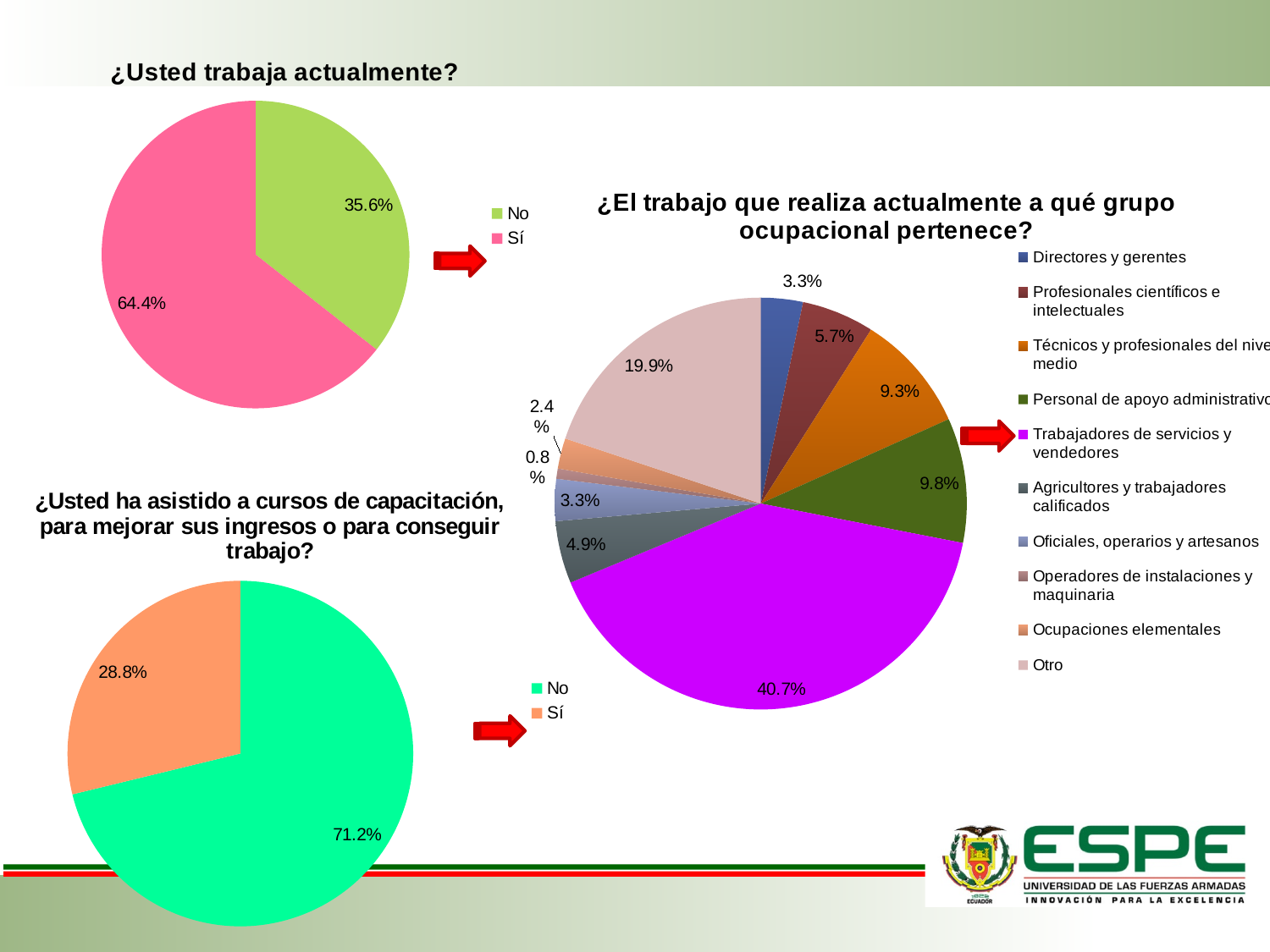
In the chart titled '¿El trabajo que realiza actualmente a qué grupo ocupacional pertenece?', how many occupational groups does the legend list? 10 In the chart titled '¿El trabajo que realiza actualmente a qué grupo ocupacional pertenece?', which group has the largest share? Trabajadores de servicios y vendedores In the chart titled '¿El trabajo que realiza actualmente a qué grupo ocupacional pertenece?', what is the difference between the shares for Trabajadores de servicios y vendedores and Otro? 20.8% In the chart titled '¿Usted trabaja actualmente?', what percentage answered Sí? 64.4% In the chart titled '¿Usted ha asistido a cursos de capacitación, para mejorar sus ingresos o para conseguir trabajo?', which answer has the larger share, Sí or No? No In the chart titled '¿Usted trabaja actualmente?', what percentage answered No? 35.6% In the chart titled '¿El trabajo que realiza actualmente a qué grupo ocupacional pertenece?', which group has the smallest share? Operadores de instalaciones y maquinaria What kind of chart is used for '¿Usted trabaja actualmente?'? Pie chart In the chart titled '¿El trabajo que realiza actualmente a qué grupo ocupacional pertenece?', what is the share for Otro? 19.9% In the chart titled '¿El trabajo que realiza actualmente a qué grupo ocupacional pertenece?', what is the share for Agricultores y trabajadores calificados? 4.9% In the chart titled '¿Usted ha asistido a cursos de capacitación, para mejorar sus ingresos o para conseguir trabajo?', what percentage answered No? 71.2% In the chart titled '¿Usted trabaja actualmente?', what is the difference between the Sí and No shares? 28.8%